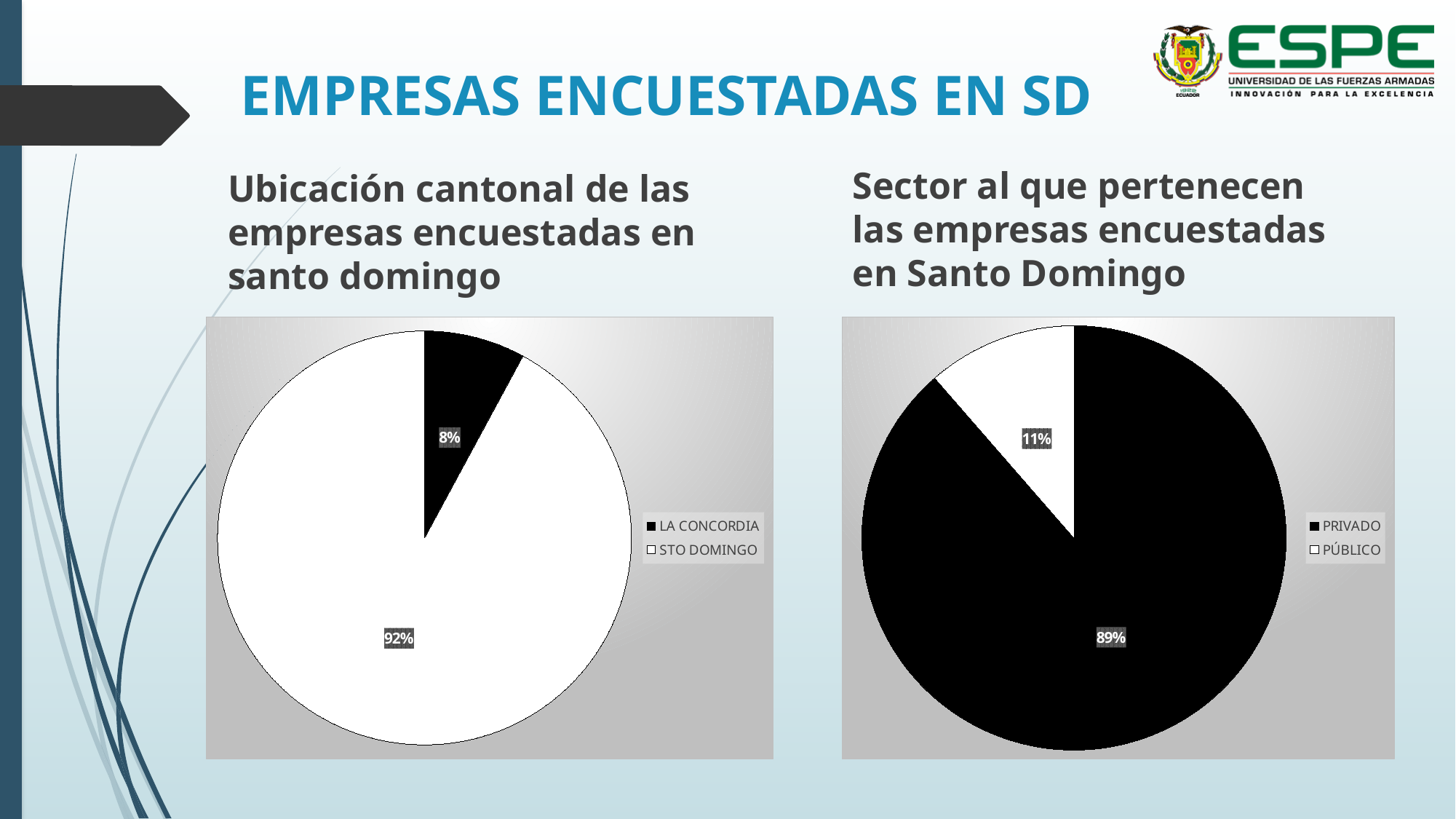
In the right chart (Sector al que pertenecen), which category has the smallest slice? PÚBLICO In the right chart (Sector al que pertenecen), what share of the surveyed companies is PRIVADO? 89% In the right chart (Sector al que pertenecen), which is larger, PRIVADO or PÚBLICO? PRIVADO In the right chart (Sector al que pertenecen), what share of the surveyed companies is PÚBLICO? 11% In the left chart (Ubicación cantonal), what colour is the LA CONCORDIA slice? Black In the left chart (Ubicación cantonal), what share of the surveyed companies is in STO DOMINGO? 92% How many categories does the legend of the right chart (Sector al que pertenecen) list? 2 In the right chart (Sector al que pertenecen), what is the difference in percentage points between PRIVADO and PÚBLICO? 78 What type of chart is used in the left chart (Ubicación cantonal)? Pie chart In the left chart (Ubicación cantonal), which category has the largest slice? STO DOMINGO In the left chart (Ubicación cantonal), what share of the surveyed companies is in LA CONCORDIA? 8% In the left chart (Ubicación cantonal), what is the difference in percentage points between STO DOMINGO and LA CONCORDIA? 84